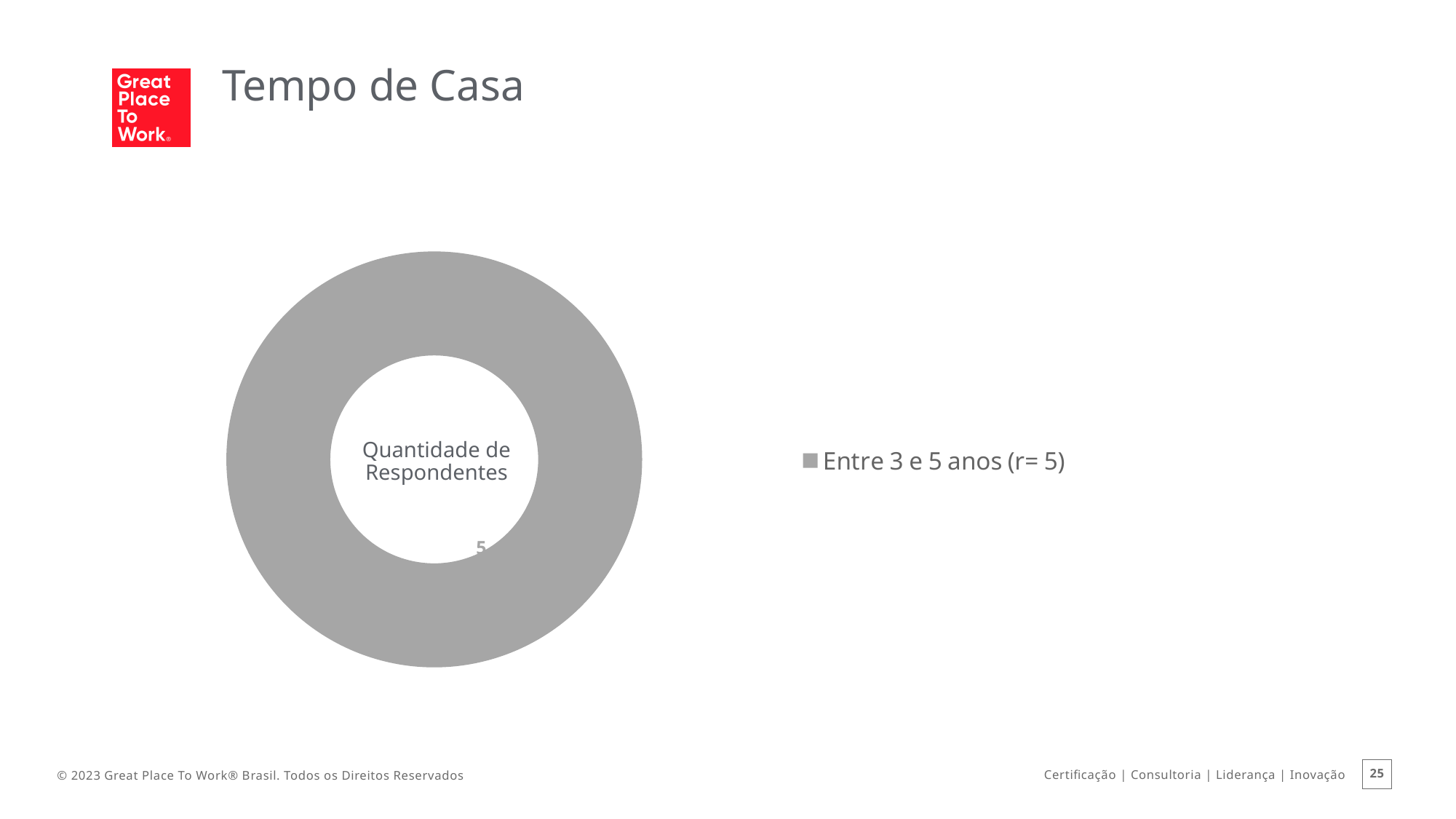
How many entries does the legend list? 1 What is the total number of respondents shown in the chart? 5 What text appears in the centre of the doughnut chart? Quantidade de Respondentes What is the value shown for the "Entre 3 e 5 anos" slice? 5 What is the title of the slide containing the chart? Tempo de Casa How many categories does the chart contain? 1 What share of the doughnut does the "Entre 3 e 5 anos" slice represent? 100% What kind of chart is shown on the slide? Doughnut (pie) chart